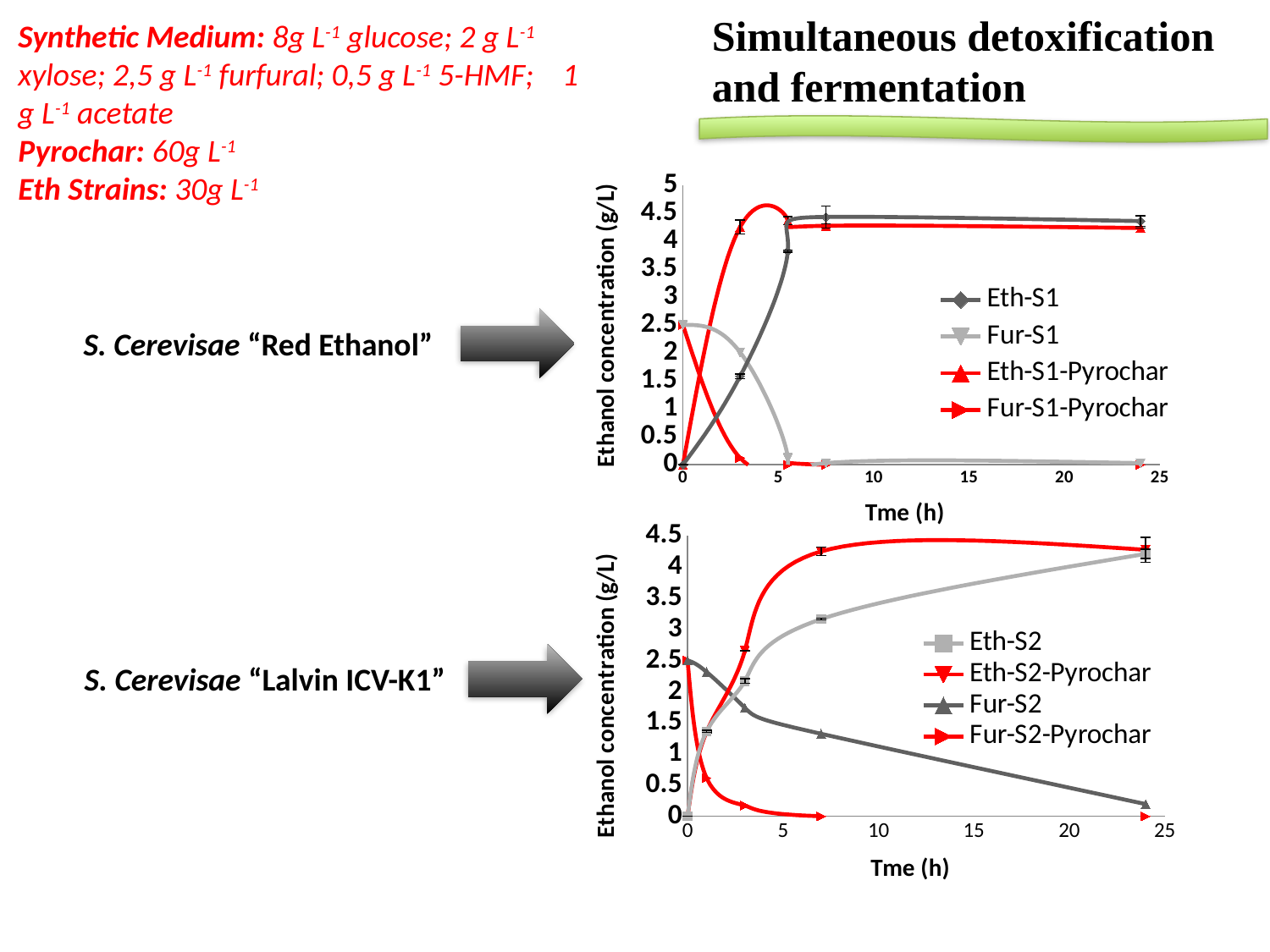
In the bottom chart, at 7 h, which is larger: Eth-S2 or Eth-S2-Pyrochar? Eth-S2-Pyrochar In the top chart, at 3 h, which is larger: Eth-S1 or Eth-S1-Pyrochar? Eth-S1-Pyrochar How many series does the legend of the top chart list? 4 What is the x-axis title of the bottom chart? Tme (h) In the top chart, is the value for Fur-S1 at 24 h greater or less than 0.5? less How many series does the legend of the bottom chart list? 4 In the bottom chart, is the value for Fur-S2 at 24 h greater or less than 0.5? less In the top chart, which series are listed in the legend? Eth-S1, Fur-S1, Eth-S1-Pyrochar, Fur-S1-Pyrochar In the bottom chart, does the Fur-S2 series rise or fall as time increases? fall In the bottom chart, is the value for Eth-S2-Pyrochar at 7 h greater or less than 4? greater What kind of chart is the top chart on the slide? line chart